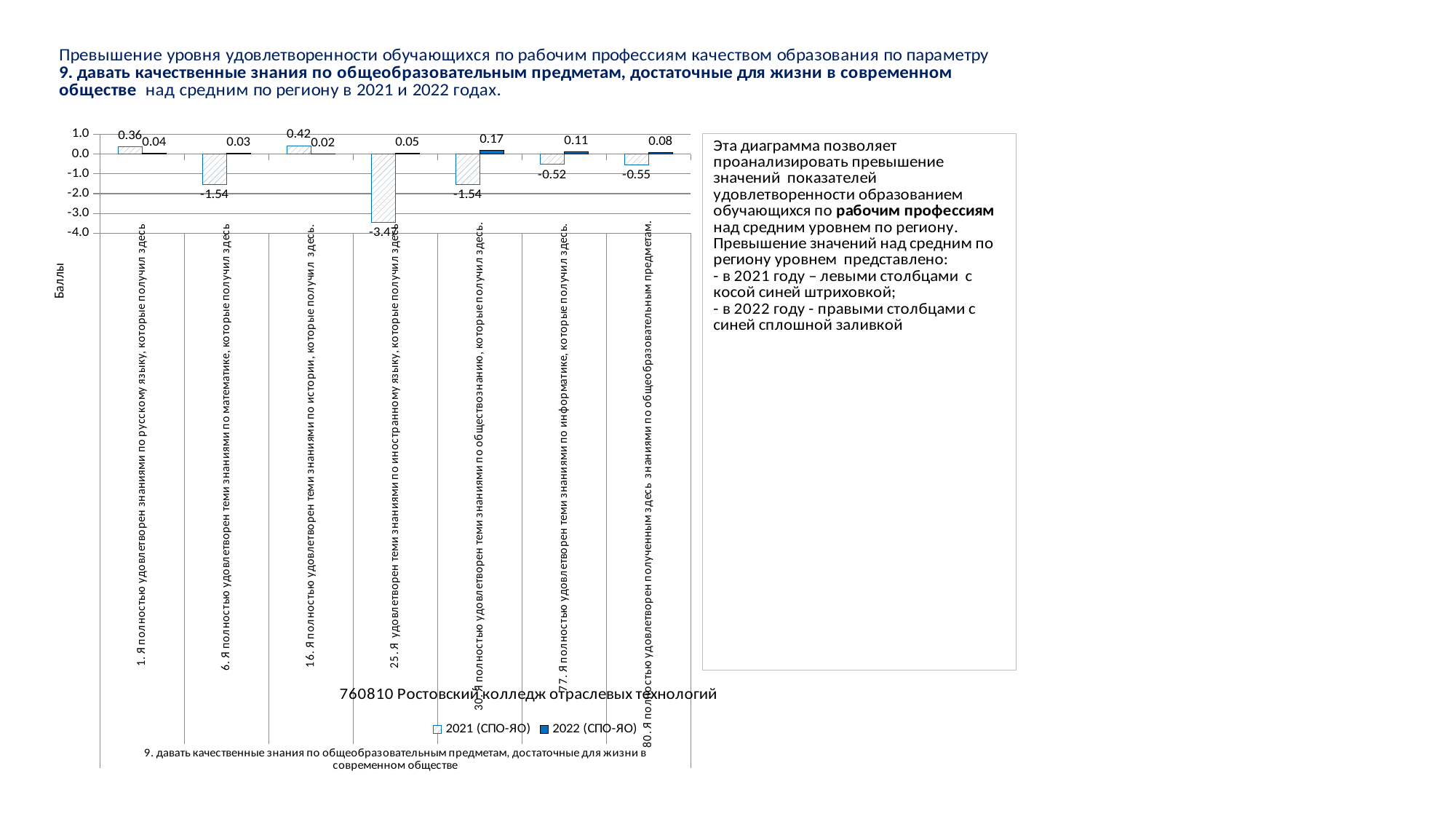
Which is larger: the 2021 value for category 16 (знаниями по истории) or the 2021 value for category 1 (знаниями по русскому языку)? Category 16 (знаниями по истории), 0.42 What are the two legend entries of the chart? 2021 (СПО-ЯО) and 2022 (СПО-ЯО) What is the difference between the 2021 and 2022 values for category 1 (знаниями по русскому языку)? 0.32 What is the 2022 (СПО-ЯО) value for category 25 (знаниями по иностранному языку)? 0.05 How many series does the chart legend list? 2 How many categories are shown on the x axis of the chart? 7 Which category has the highest 2022 (СПО-ЯО) value? 30. Я полностью удовлетворен теми знаниями по обществознанию (0.17) What is the 2021 (СПО-ЯО) value for category 1 (знаниями по русскому языку)? 0.36 Is the 2021 value for category 25 (знаниями по иностранному языку) greater or less than -3.0? less What is the 2021 (СПО-ЯО) value for category 77 (знаниями по информатике)? -0.52 What type of chart is shown on the slide? Bar chart Which category has the lowest 2021 (СПО-ЯО) value? 25. Я удовлетворен теми знаниями по иностранному языку (-3.47)